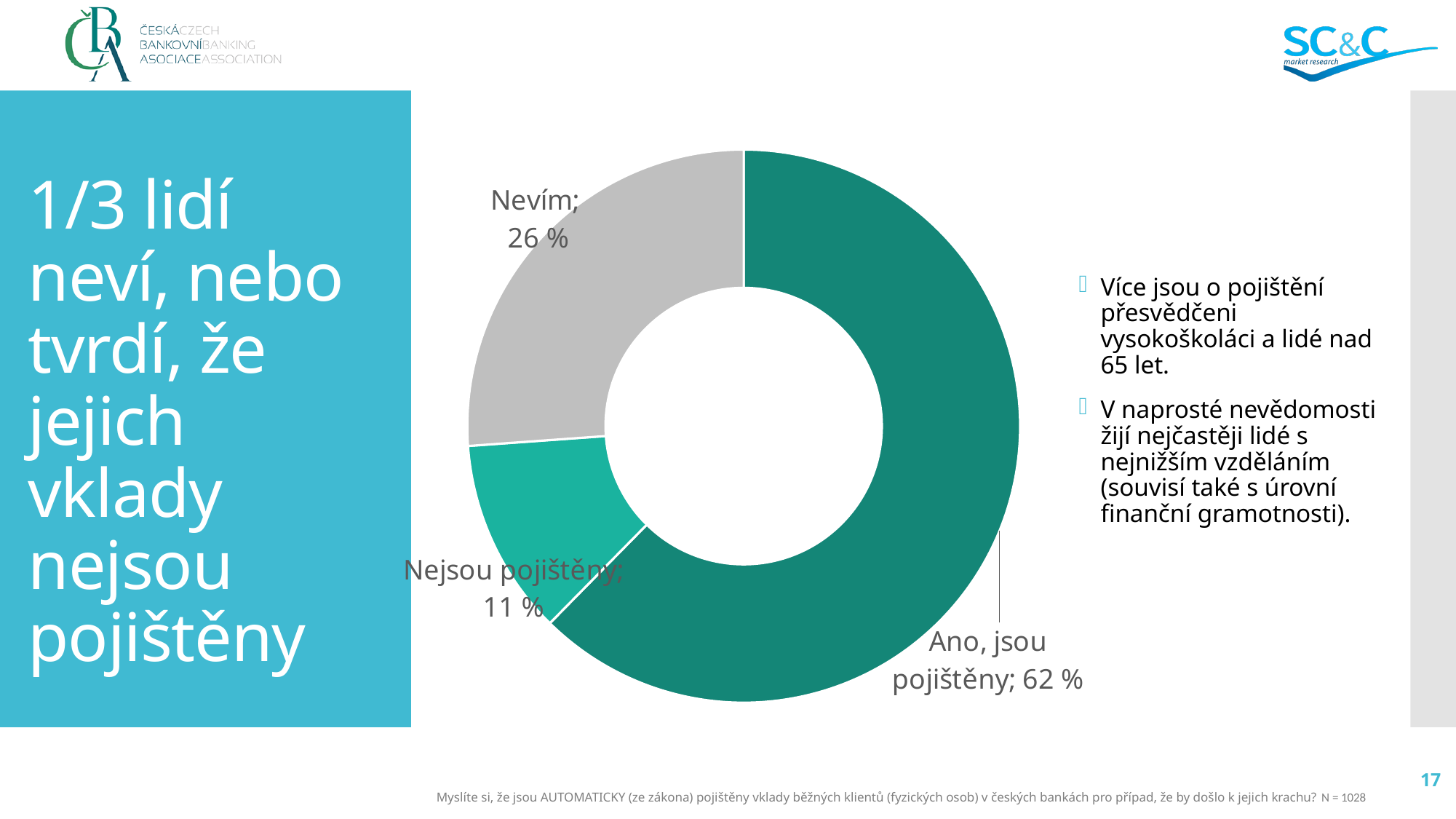
What colour is the "Nevím" slice of the chart? Grey What share of respondents answered "Nejsou pojištěny"? 11 % Which answer category has the largest share in the chart? Ano, jsou pojištěny What is the difference in percentage points between "Ano, jsou pojištěny" and "Nevím"? 36 What kind of chart is shown on the slide? Doughnut (pie) chart How many categories does the chart show? 3 Which answer category has the smallest share in the chart? Nejsou pojištěny What is the difference in percentage points between "Nevím" and "Nejsou pojištěny"? 15 What share of respondents answered "Ano, jsou pojištěny"? 62 % Which is larger: the share for "Nevím" or the share for "Nejsou pojištěny"? Nevím What is the combined share of "Nevím" and "Nejsou pojištěny"? 37 % What share of respondents answered "Nevím"? 26 %